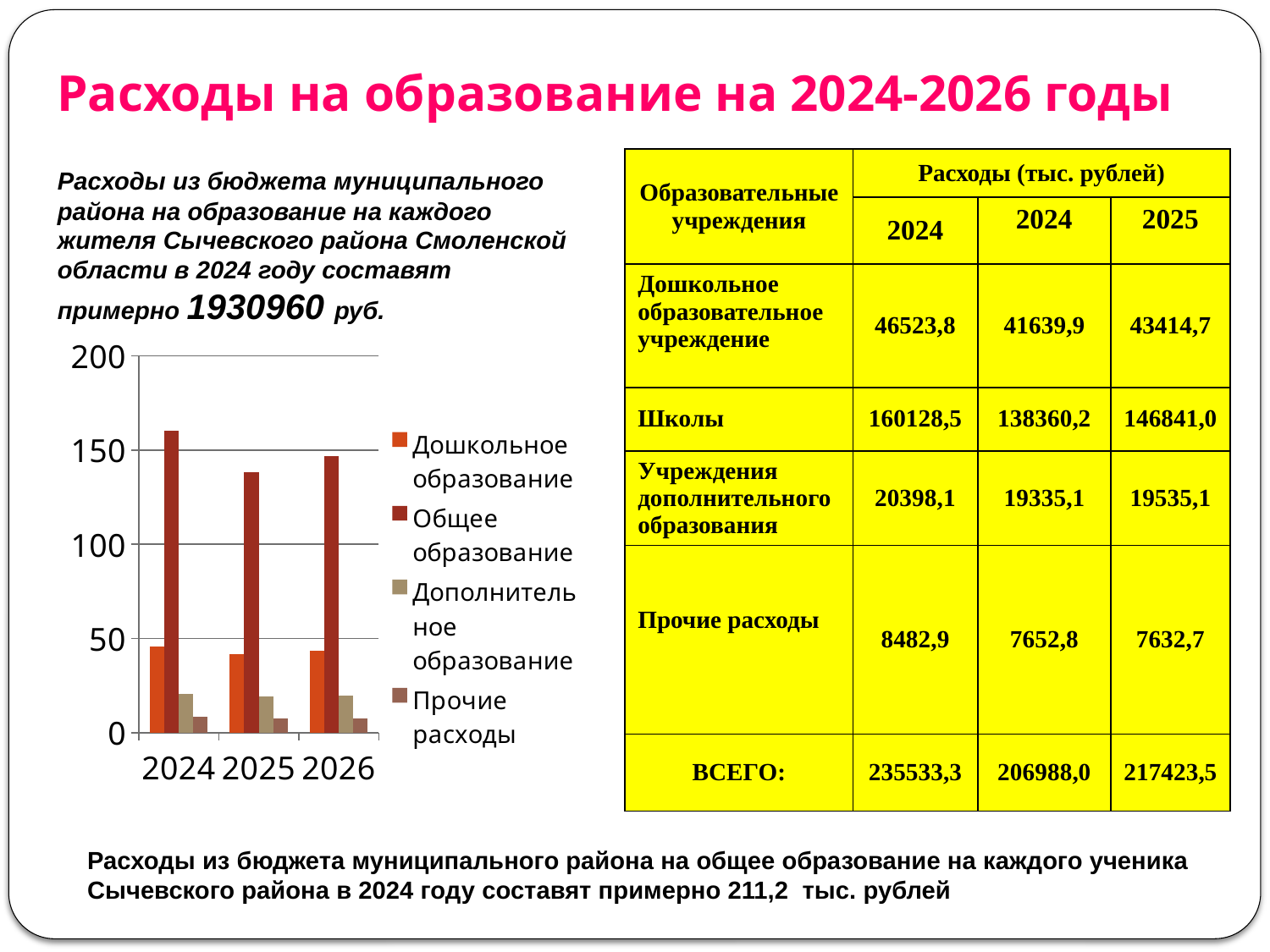
Which is larger: Дошкольное образование in 2024 or Прочие расходы in 2024? Дошкольное образование Which series has the tallest bar in 2024? Общее образование Is the value for Дополнительное образование in 2025 greater or less than 50? less Which year is the first category on the x axis of the chart? 2024 Is the value for Общее образование in 2024 greater or less than 150? greater Is the value for Общее образование in 2025 greater or less than 150? less Which is larger: Общее образование in 2024 or Общее образование in 2025? 2024 Which series has the shortest bar in 2026? Прочие расходы How many years are shown on the x axis of the chart? 3 What kind of chart is shown on the slide? bar chart How many series does the chart legend list? 4